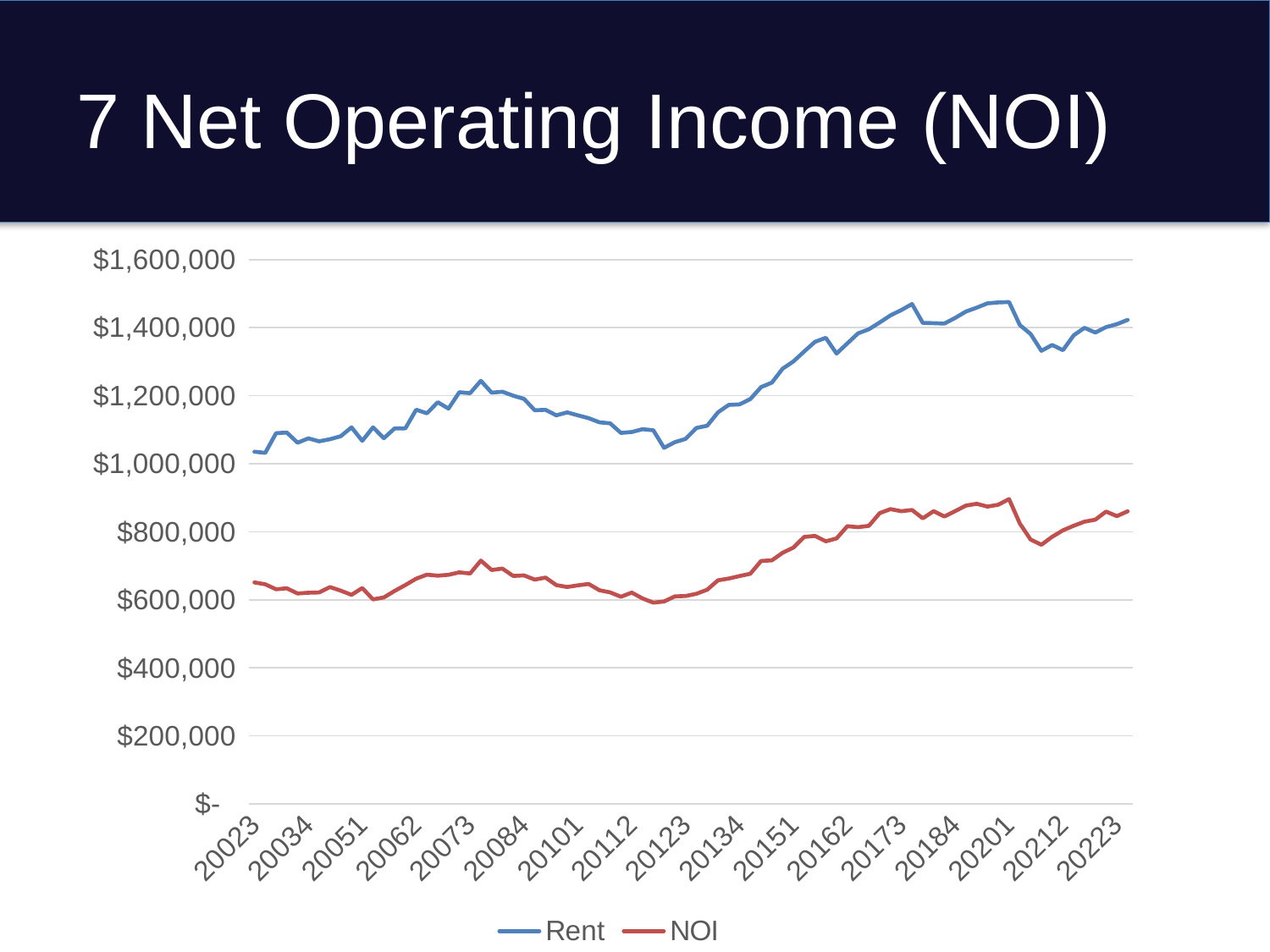
Is the Rent value at 20173 greater or less than $1,400,000? greater Is the Rent value at 20023 greater or less than $1,000,000? greater Is the Rent value at 20212 greater or less than $1,400,000? less Does the NOI series rise or fall between 20073 and 20123? fall What is the title of the slide containing the chart? 7 Net Operating Income (NOI) Which series is plotted higher throughout the chart, Rent or NOI? Rent How many series does the legend list? 2 What type of chart is shown on the slide? Line chart Does the Rent series rise or fall between 20123 and 20173? rise What are the two series named in the legend? Rent and NOI